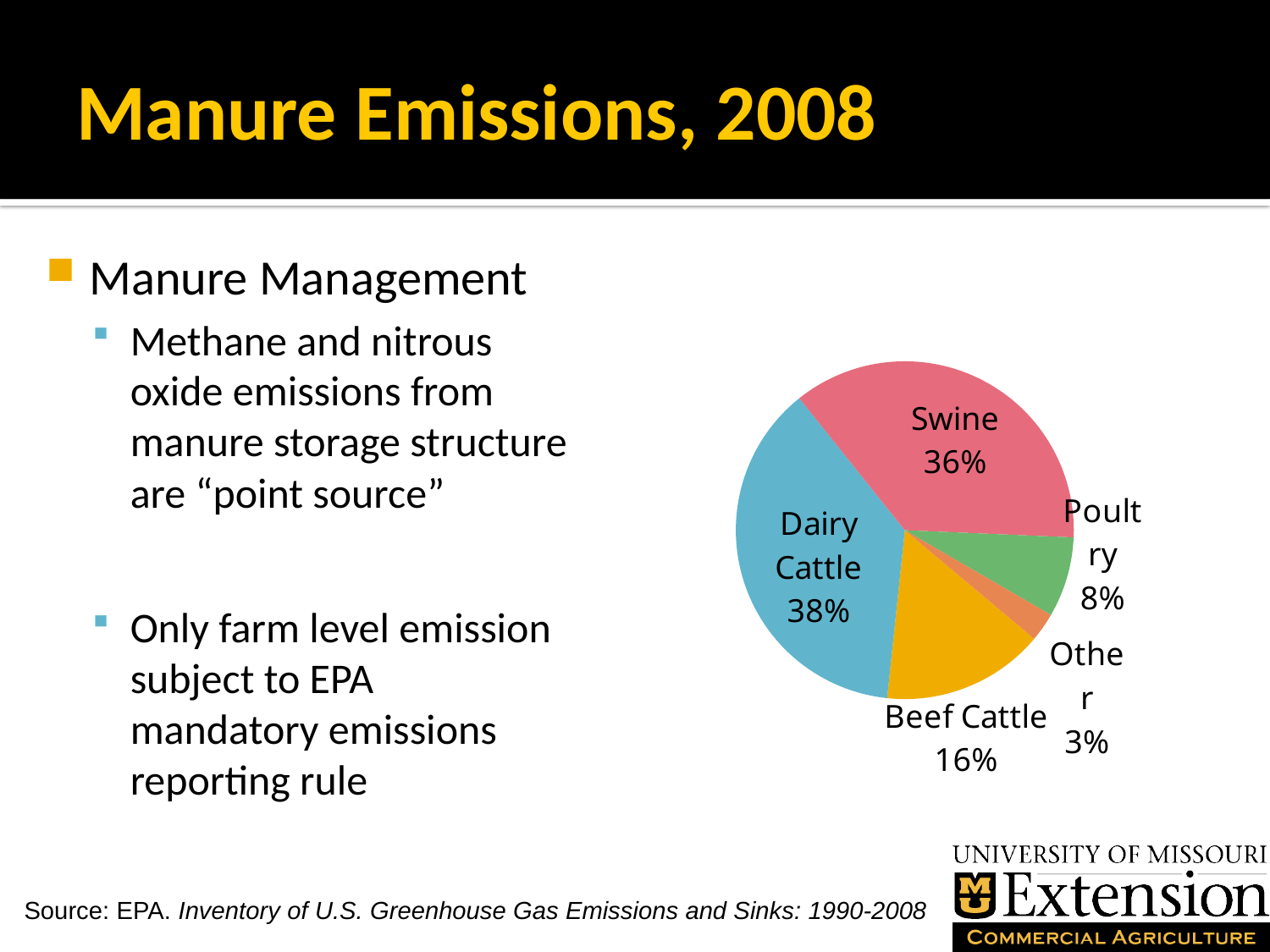
How many categories are shown in the pie chart? 5 What share of the pie does Dairy Cattle account for? 38% What kind of chart is shown on the slide? pie chart What share of the pie does Swine account for? 36% What colour is the Dairy Cattle slice? blue What share of the pie does Other account for? 3% Which category has the largest slice of the pie? Dairy Cattle Which is larger, the share for Poultry or the share for Beef Cattle? Beef Cattle What is the difference in percentage points between Dairy Cattle and Beef Cattle? 22 Which category has the smallest slice of the pie? Other What share of the pie does Poultry account for? 8% What share of the pie does Beef Cattle account for? 16%